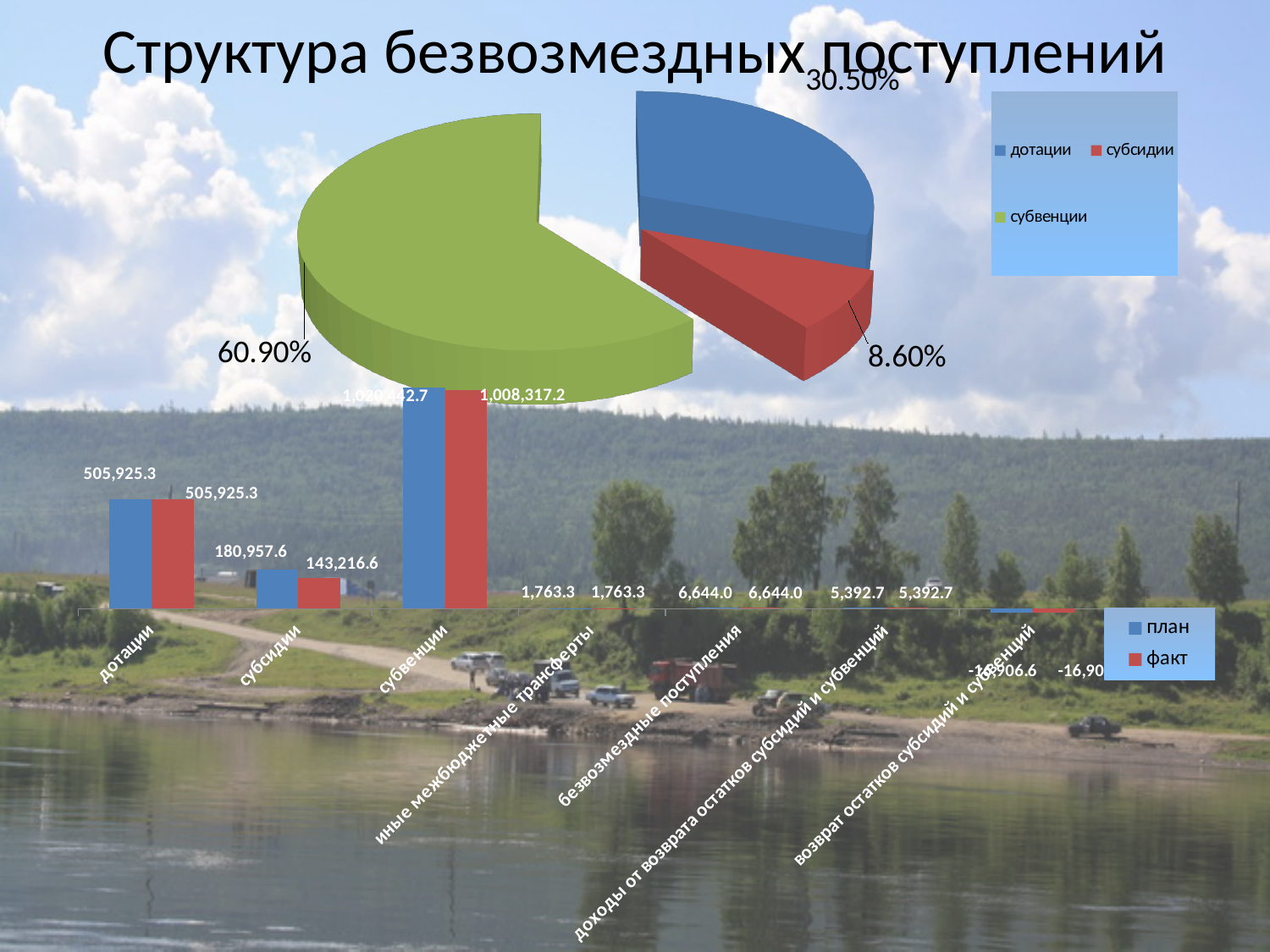
In the pie chart, what share is shown for субвенции? 60.90% How many series does the bar chart legend list? 2 In the bar chart, what is the факт value for субсидии? 143,216.6 In the bar chart, what is the difference between the план and факт values for субсидии? 37,741.0 In the pie chart, what share is shown for субсидии? 8.60% In the bar chart, what is the факт value for субвенции? 1,008,317.2 In the pie chart, which category has the smallest slice? субсидии In the pie chart, which category has the largest slice? субвенции In the bar chart, what is the план value for дотации? 505,925.3 In the pie chart, what share is shown for дотации? 30.50% In the bar chart, which is larger for субсидии: план or факт? план How many categories does the pie chart legend list? 3